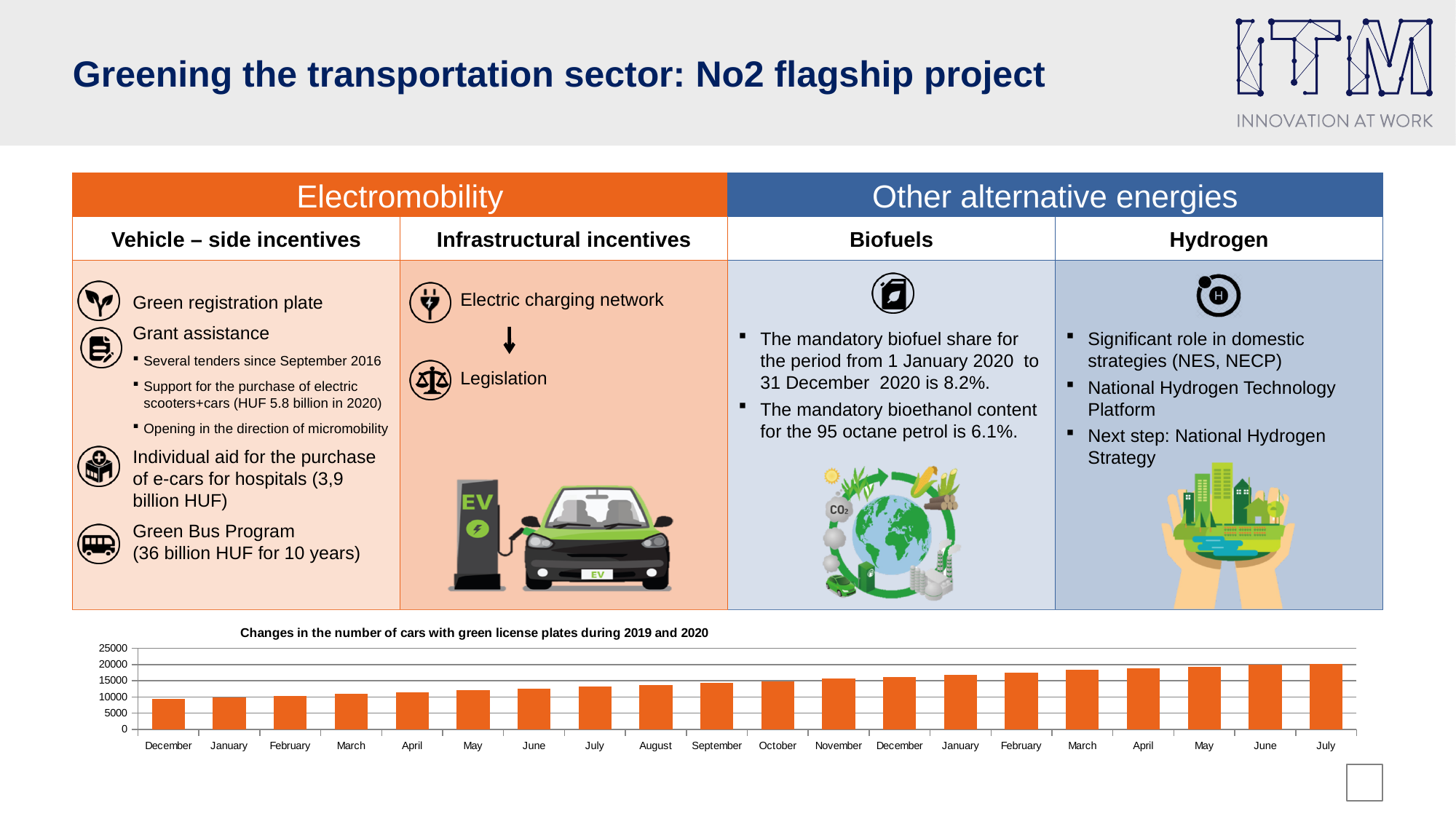
Which month has the lowest bar in the chart? December (the first bar) What is the title of the chart at the bottom of the slide? Changes in the number of cars with green license plates during 2019 and 2020 Is the value for the first December bar greater or less than 15000? less What is the highest value shown on the y axis of the chart? 25000 What kind of chart is shown at the bottom of the slide? bar chart Which is larger, the value for the last July bar or the value for the first December bar? July (the last bar) Is the value for the second March bar greater or less than 15000? greater Is the value for the last July bar greater or less than 15000? greater Do the values in the chart rise or fall from left to right along the x axis? rise How many bars are plotted in the chart at the bottom of the slide? 20 Which month has the highest bar in the chart? July (the last bar)